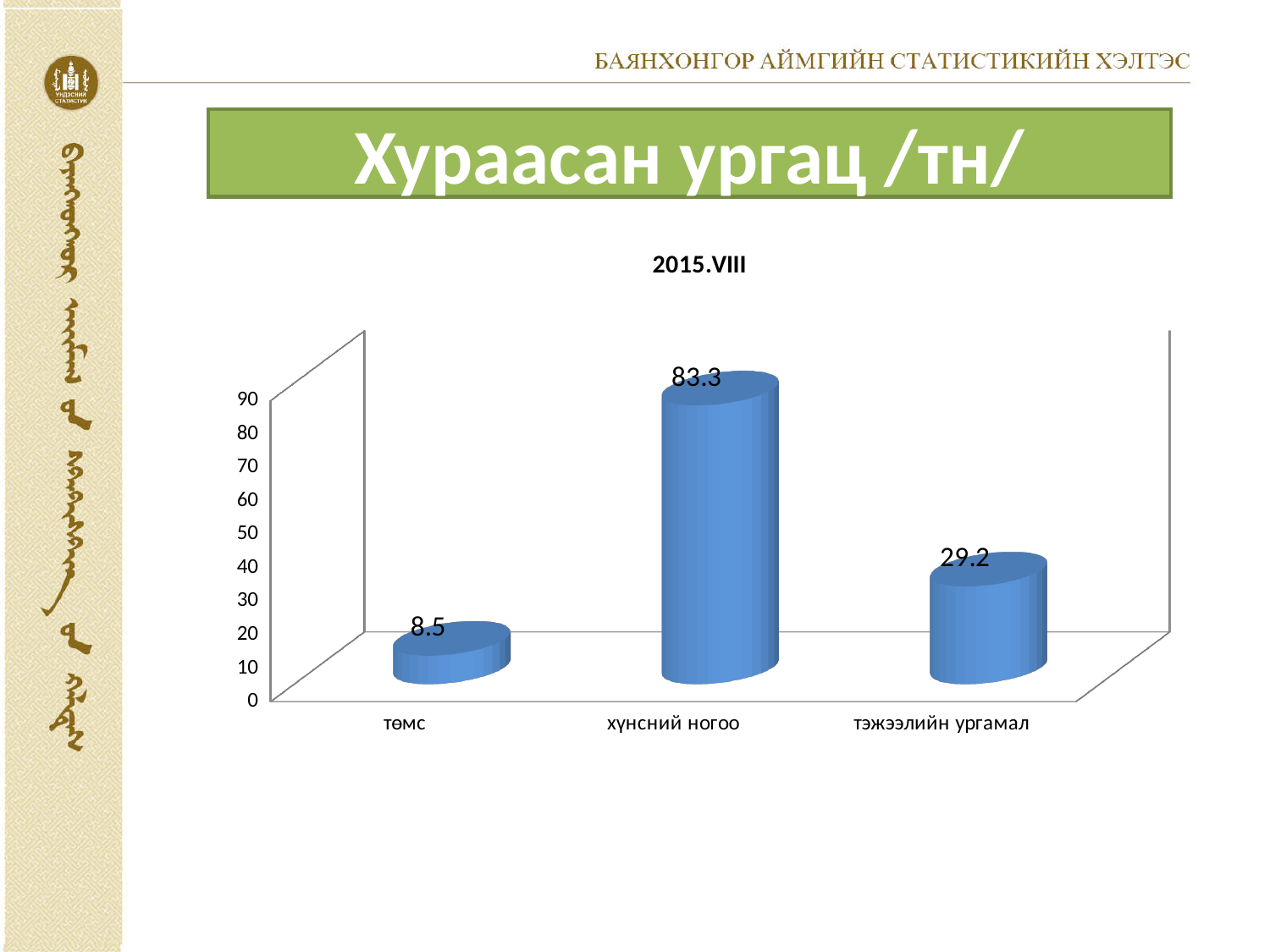
What is the difference between the values for хүнсний ногоо and тэжээлийн ургамал? 54.1 What is the value for тэжээлийн ургамал? 29.2 What is the value for төмс? 8.5 Which is larger, the value for төмс or the value for тэжээлийн ургамал? тэжээлийн ургамал What kind of chart is shown on the slide? bar chart What is the difference between the values for тэжээлийн ургамал and төмс? 20.7 What is the title of the chart? 2015.VIII What is the value for хүнсний ногоо? 83.3 Is the value for хүнсний ногоо greater or less than 80? greater Which category has the lowest value? төмс Which category has the highest value? хүнсний ногоо How many categories are shown on the chart? 3